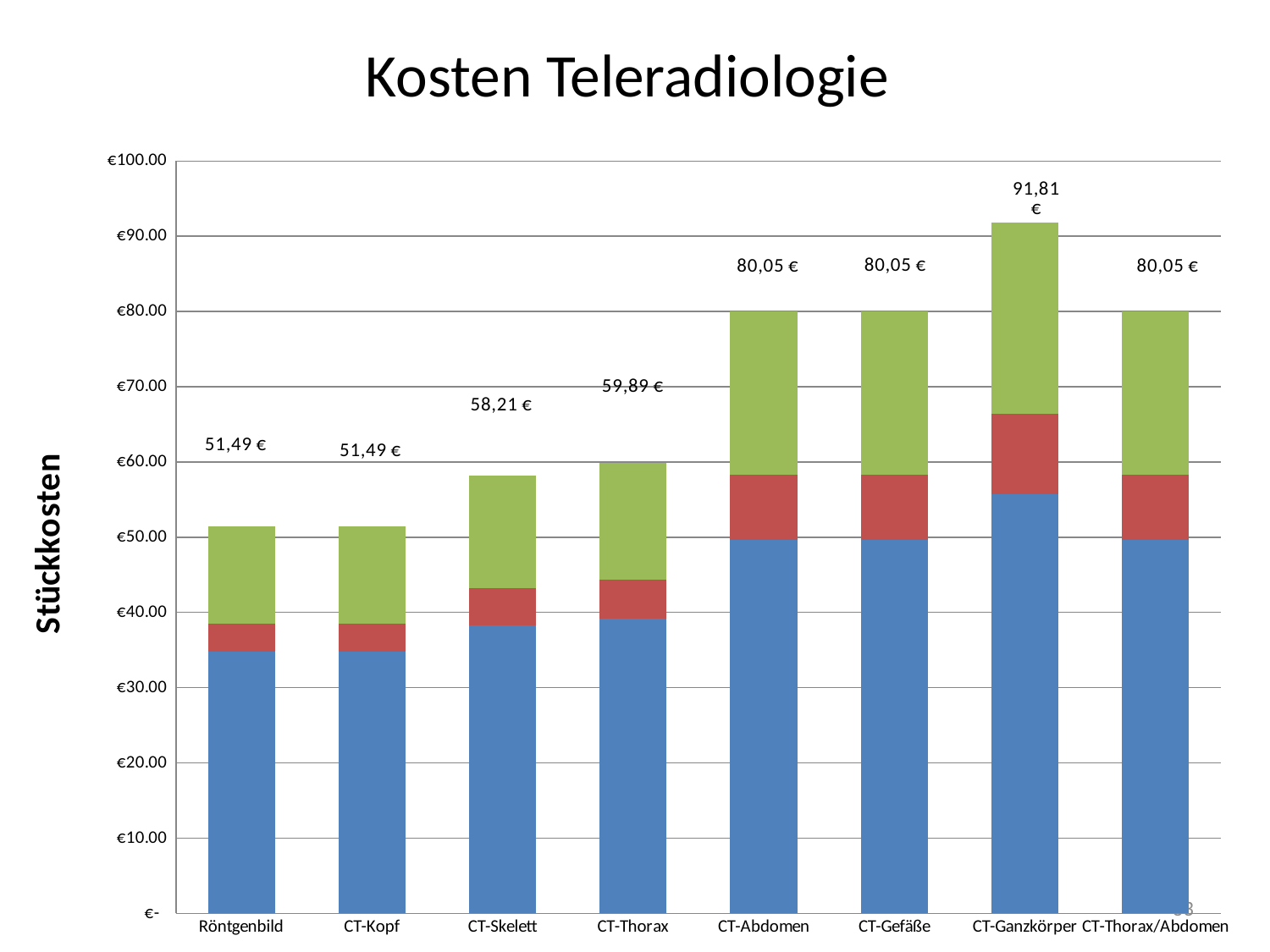
What is the label on the y axis? Stückkosten What kind of chart is shown on the slide? Stacked bar chart What is the total cost shown for CT-Abdomen? 80,05 € Which has a higher total cost, CT-Thorax or CT-Skelett? CT-Thorax Which category has the highest total cost? CT-Ganzkörper What is the lowest total cost value shown on the chart? 51,49 € Is the blue segment for Röntgenbild greater or less than €40.00? less How many categories are shown on the x axis? 8 What is the total cost shown for CT-Thorax? 59,89 € What is the total cost shown for CT-Skelett? 58,21 € What is the total cost shown for CT-Ganzkörper? 91,81 € What is the difference between the total cost of CT-Ganzkörper and CT-Gefäße? 11,76 €